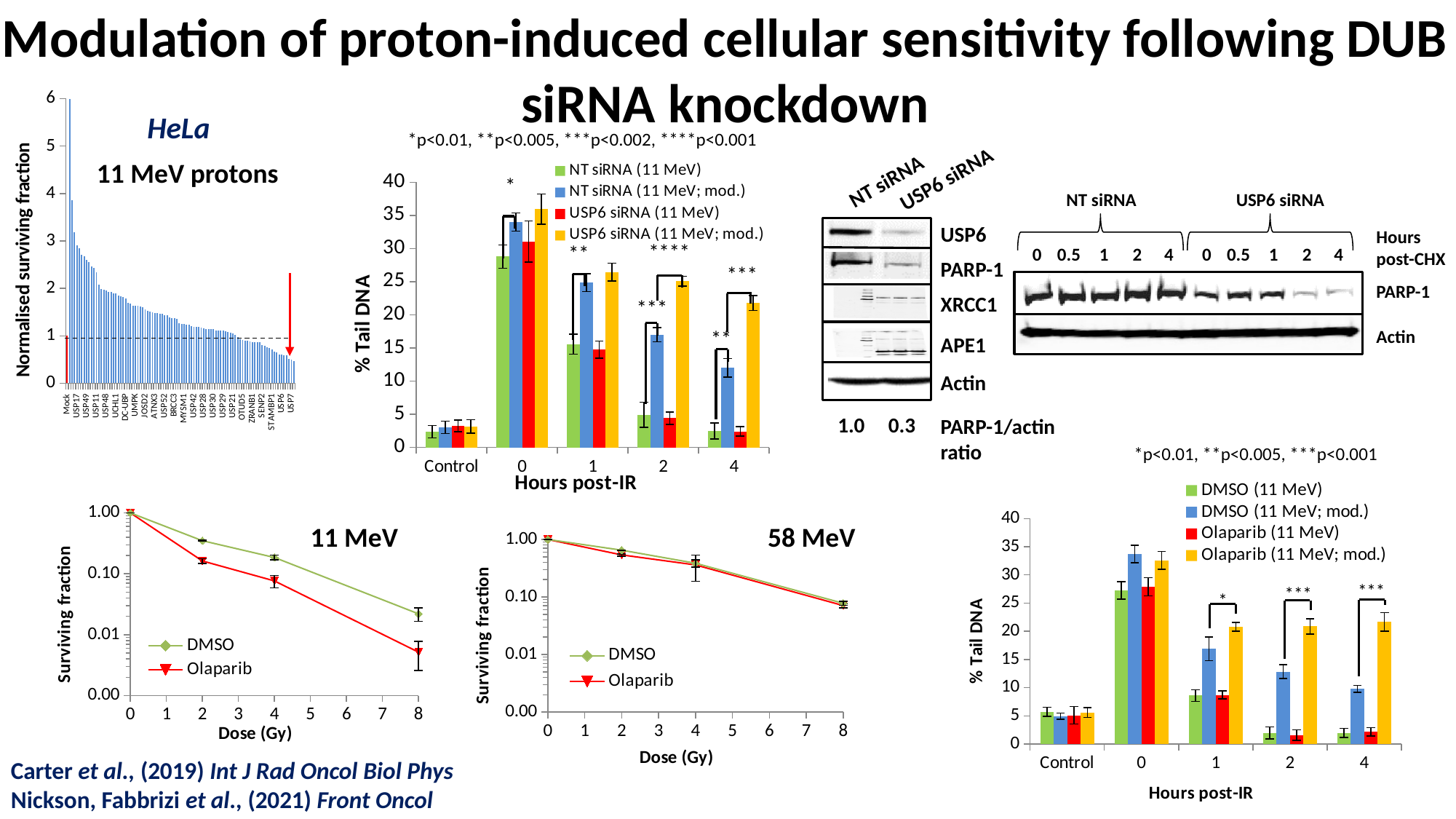
In the top-middle '% Tail DNA' chart (siRNA), is the value for NT siRNA (11 MeV; mod.) at 0 hours post-IR greater or less than 30? greater In the bottom-right '% Tail DNA' chart (DMSO/Olaparib), at 2 hours post-IR, which is larger: Olaparib (11 MeV; mod.) or DMSO (11 MeV; mod.)? Olaparib (11 MeV; mod.) In the top-middle '% Tail DNA' chart (siRNA), at 2 hours post-IR, which is larger: NT siRNA (11 MeV; mod.) or USP6 siRNA (11 MeV)? NT siRNA (11 MeV; mod.) What kind of chart is the '% Tail DNA' chart in the top middle of the slide (with the siRNA legend)? bar chart How many series does the legend list for the top-middle '% Tail DNA' chart (siRNA)? 4 What kind of chart is the '11 MeV' surviving fraction chart at the bottom left of the slide? line chart How many categories are shown on the x axis of the top-middle '% Tail DNA' chart (siRNA)? 5 What is the y-axis label of the top-left bar chart for HeLa cells? Normalised surviving fraction How many series does the legend list for the bottom-right '% Tail DNA' chart (DMSO/Olaparib)? 4 In the '58 MeV' surviving fraction chart, do the values rise or fall as dose increases? fall In the bottom-right '% Tail DNA' chart (DMSO/Olaparib), is the value for DMSO (11 MeV; mod.) at 0 hours post-IR greater or less than 30? greater